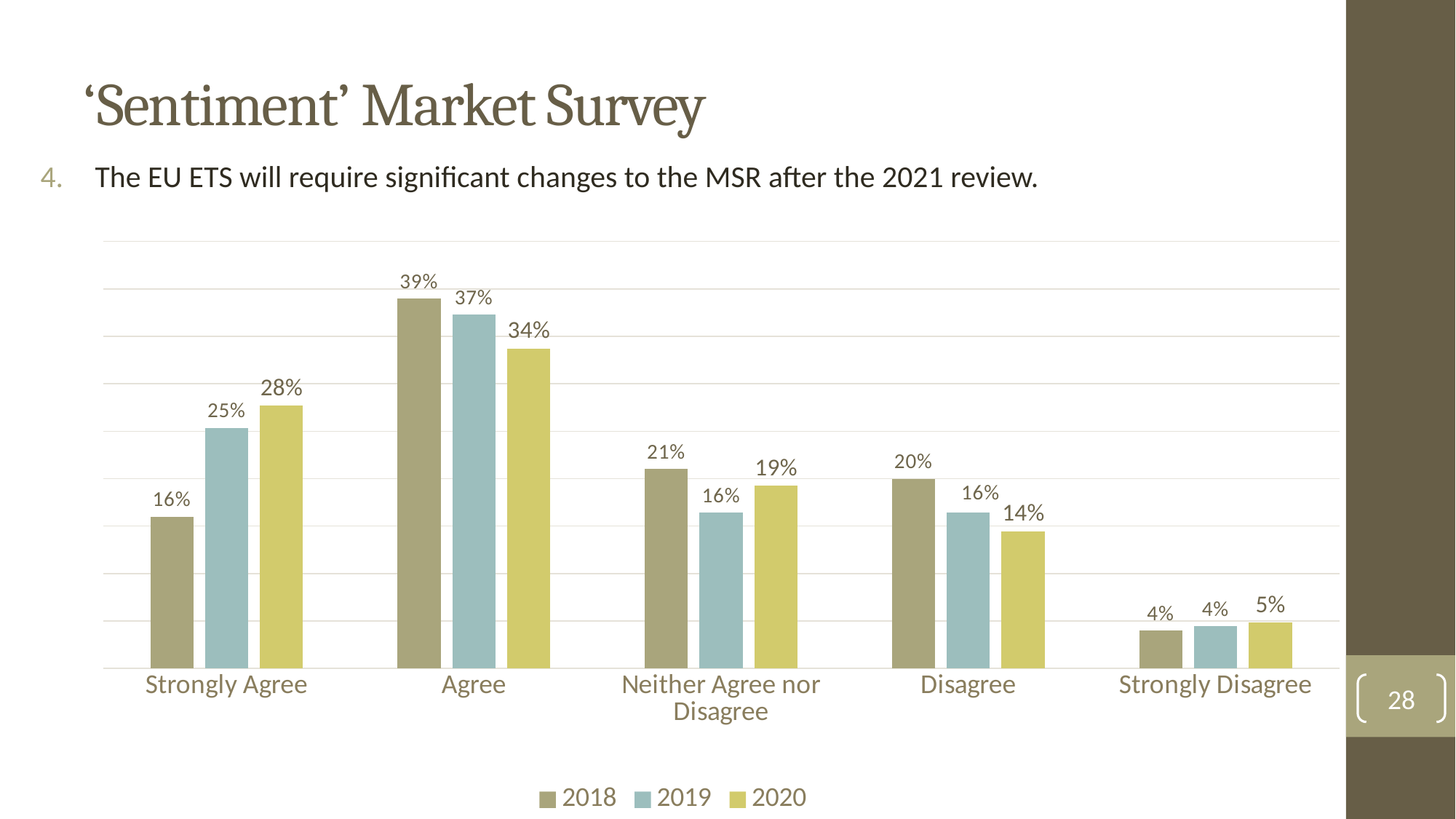
Which category has the highest value for 2018? Agree What is the difference between the 2018 and 2020 values for Strongly Agree? 12% Do the 2020 values rise or fall from Agree to Strongly Disagree? Fall What is the value for 2020 in the Agree category? 34% Which is larger: the 2018 value for Disagree or the 2020 value for Disagree? 2018 What is the value for 2019 in the Disagree category? 16% What is the value for 2018 in the Strongly Agree category? 16% Which category has the lowest value for 2020? Strongly Disagree How many categories are shown on the x axis? 5 Which years are listed in the legend? 2018, 2019, 2020 What kind of chart is shown on the slide? Bar chart How many series does the legend list? 3